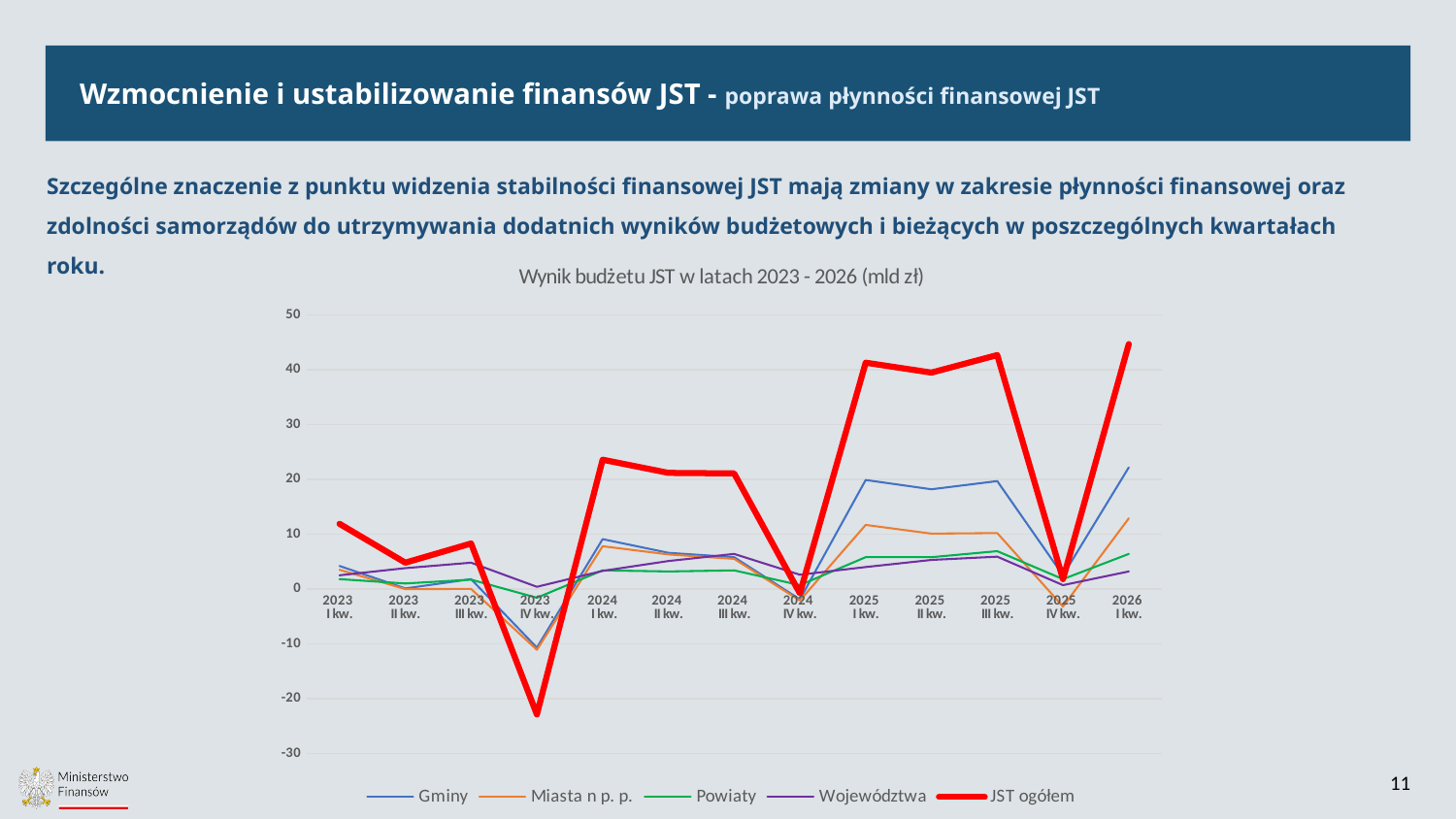
Is the value of Gminy in 2025 I kw. greater or less than 10? greater Is the value of JST ogółem in 2023 IV kw. greater or less than -20? less How many quarters (points) are plotted along the x axis of the chart? 13 Which series has the higher value in 2025 I kw., Gminy or Powiaty? Gminy What kind of chart is shown on the slide? line chart In which quarter does the JST ogółem series reach its highest value? 2026 I kw. Does the JST ogółem series rise or fall between 2025 III kw. and 2025 IV kw.? fall In which quarter does the JST ogółem series reach its lowest value? 2023 IV kw. What is the title of the chart? Wynik budżetu JST w latach 2023 - 2026 (mld zł) Which series is drawn with the thick red line? JST ogółem Is the value of JST ogółem in 2025 I kw. greater or less than 40? greater How many series does the legend of the chart list? 5